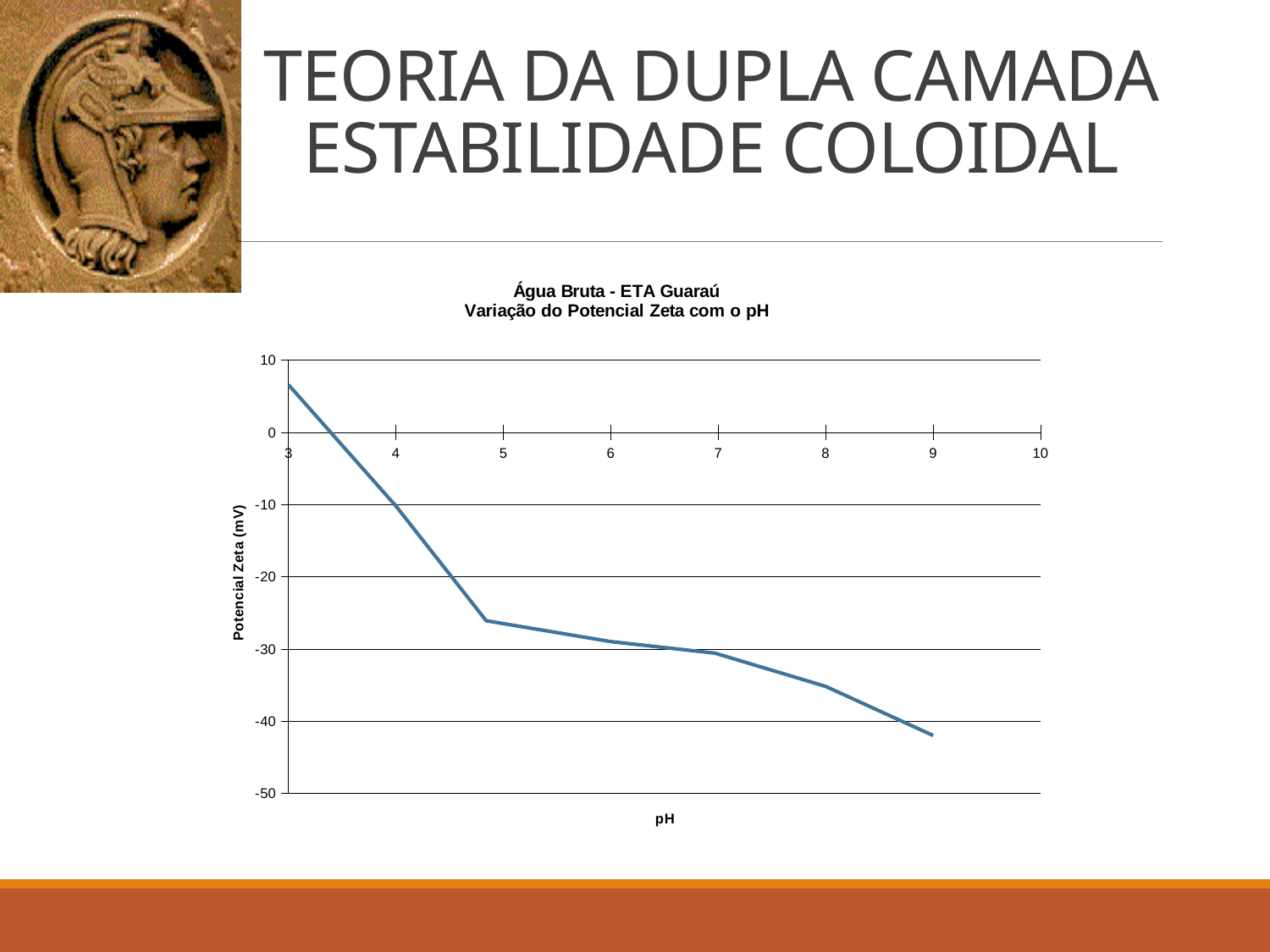
Is the zeta potential at pH 9 greater or less than -40? less Is the zeta potential at pH 7 greater or less than -20? less Which has the larger zeta potential, pH 3 or pH 9? pH 3 Is the zeta potential at pH 4 greater or less than -20? greater Does the zeta potential rise or fall as pH increases along the x axis? fall What is the label of the vertical axis? Potencial Zeta (mV) What kind of chart is shown on the slide? line chart What is the title of the chart? Água Bruta - ETA Guaraú Variação do Potencial Zeta com o pH At which pH value shown is the zeta potential highest? pH 3